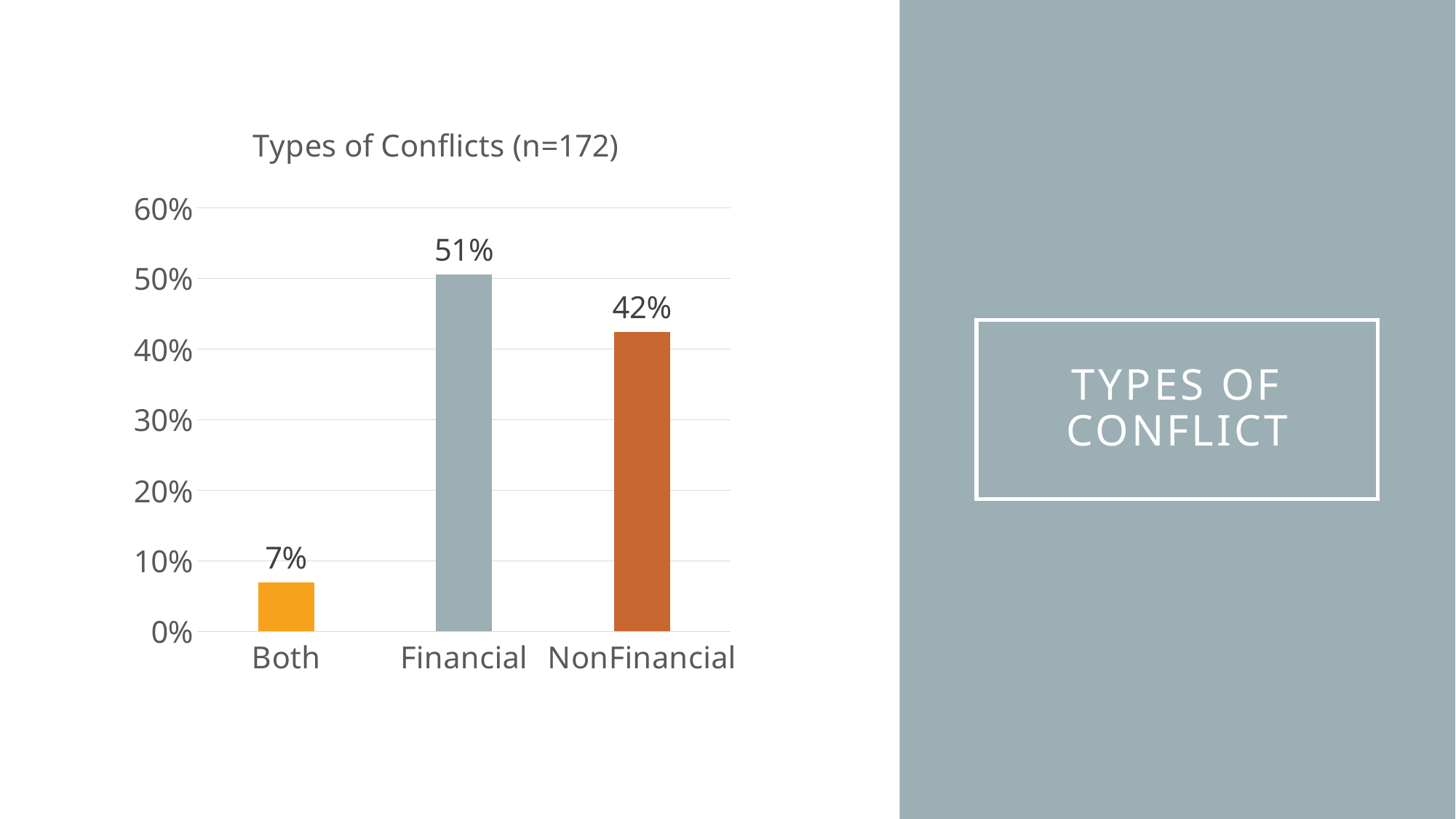
What is the value for Financial? 51% What is the value for Both? 7% Which category has the lowest value? Both How many categories are shown on the x axis? 3 What is the title of the chart? Types of Conflicts (n=172) What is the value for NonFinancial? 42% Is the value for Financial greater or less than 40%? greater What kind of chart is shown on the slide? bar chart Which is larger, the value for Both or the value for NonFinancial? NonFinancial What is the difference between the values for NonFinancial and Both? 35% Which category has the highest value? Financial What is the difference between the values for Financial and NonFinancial? 9%